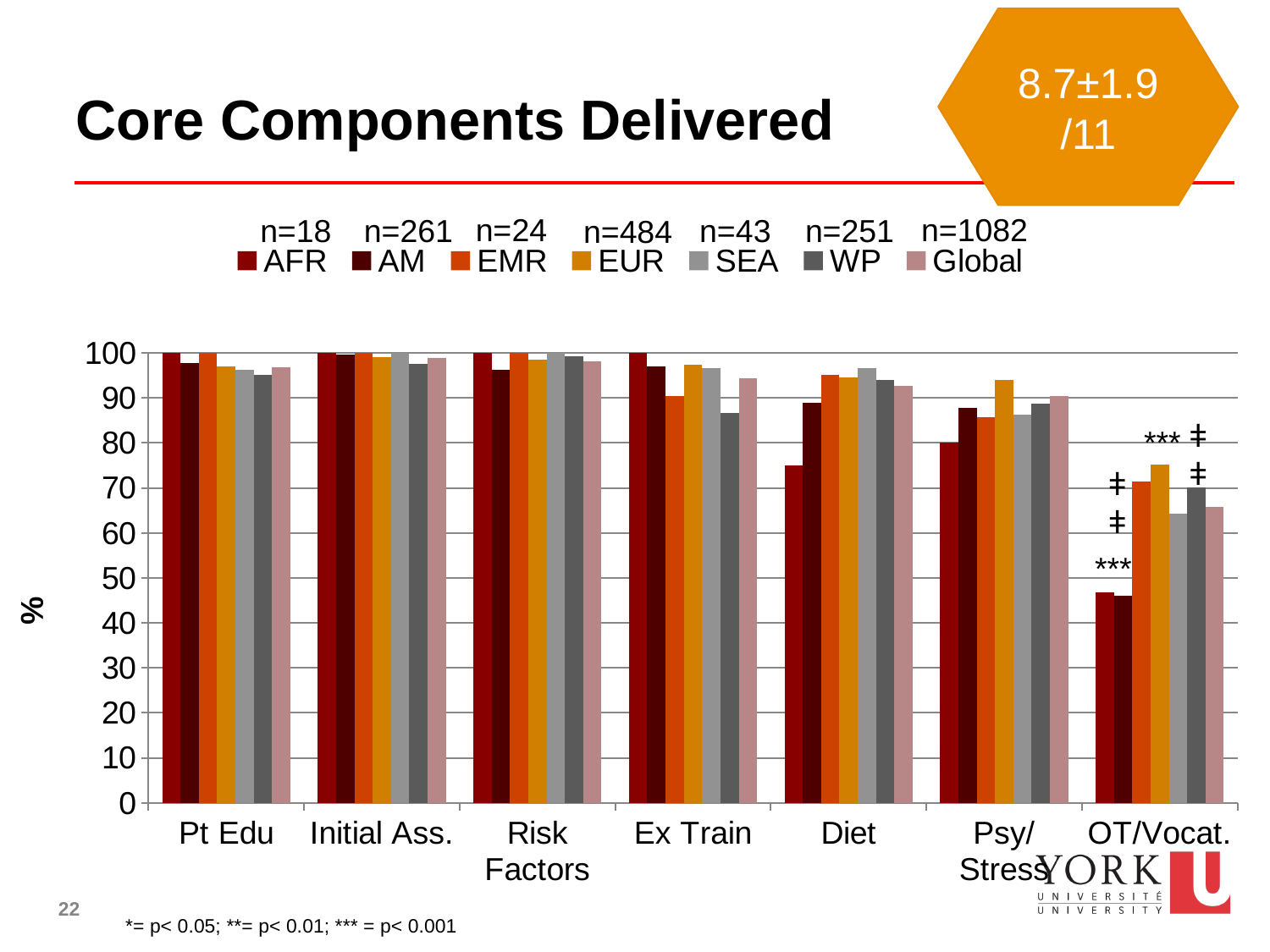
Is the EUR value for OT/Vocat. greater or less than 70? greater What kind of chart is shown on the slide? bar chart Is the AFR value for Diet greater or less than 80? less Is the AFR value for OT/Vocat. greater or less than 50? less Which category has the lowest Global value? OT/Vocat. For Diet, which is larger: the AFR value or the EUR value? EUR What is the label on the y axis? % How many core component categories are shown along the x axis? 7 Which series has the highest value for OT/Vocat.? EUR How many series does the legend list? 7 What is the sample size (n) shown above the EUR legend entry? n=484